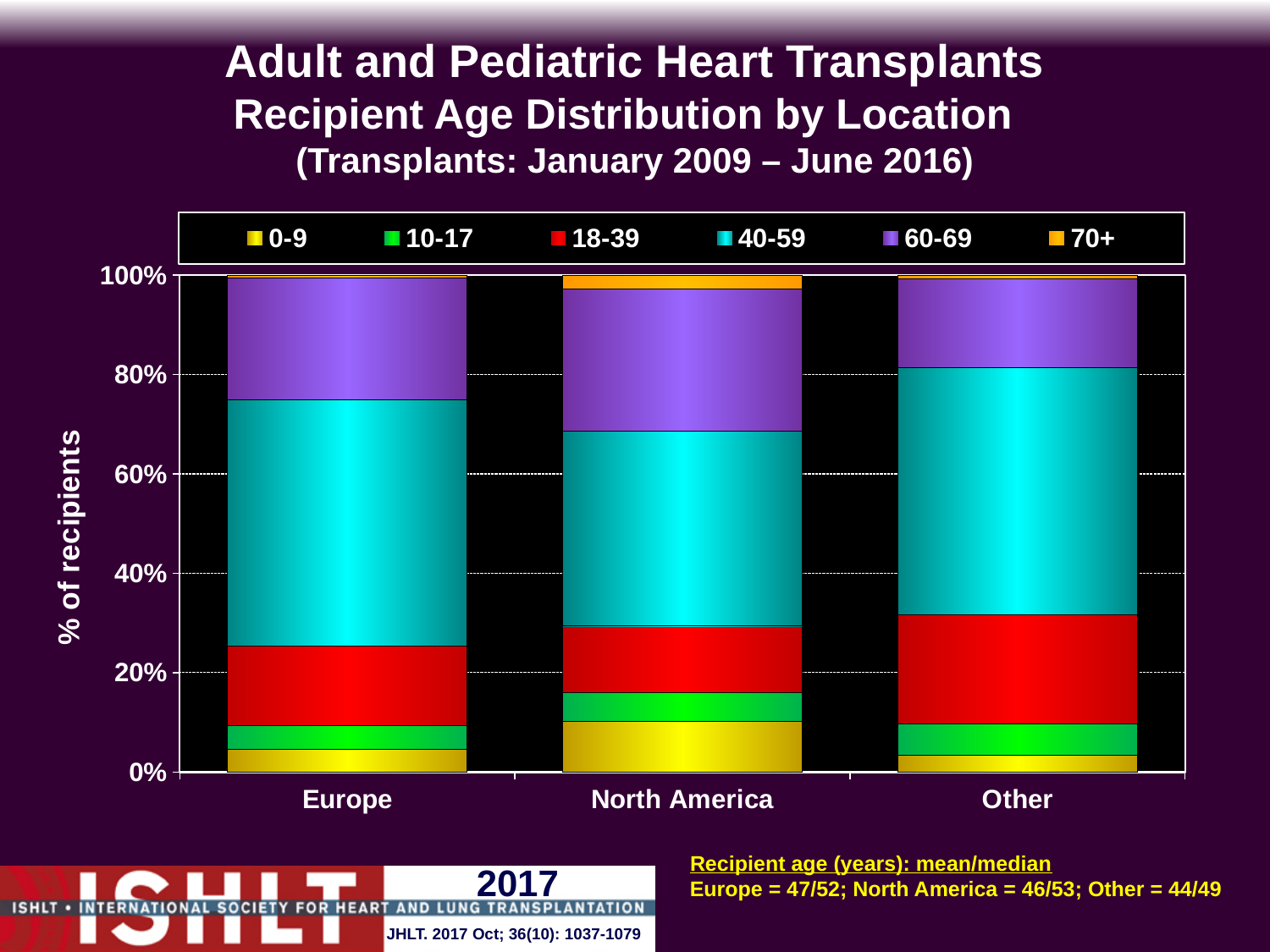
Which has a larger share of recipients aged 60-69, North America or Other? North America Which location has the smallest share of recipients aged 40-59? North America Is the share of recipients aged 0-9 in Europe greater or less than 20%? less What is the total height of the stacked bar for Europe? 100% Which has a larger share of recipients aged 18-39, Other or North America? Other Which location has the largest share of recipients aged 0-9? North America What kind of chart is shown on the slide? Stacked bar chart How many age groups does the legend list? 6 What is the label on the y axis? % of recipients How many locations are shown along the x axis? 3 What time period of transplants does the chart title cover? January 2009 – June 2016 Is the share of recipients aged 40-59 in Other greater or less than 40%? greater